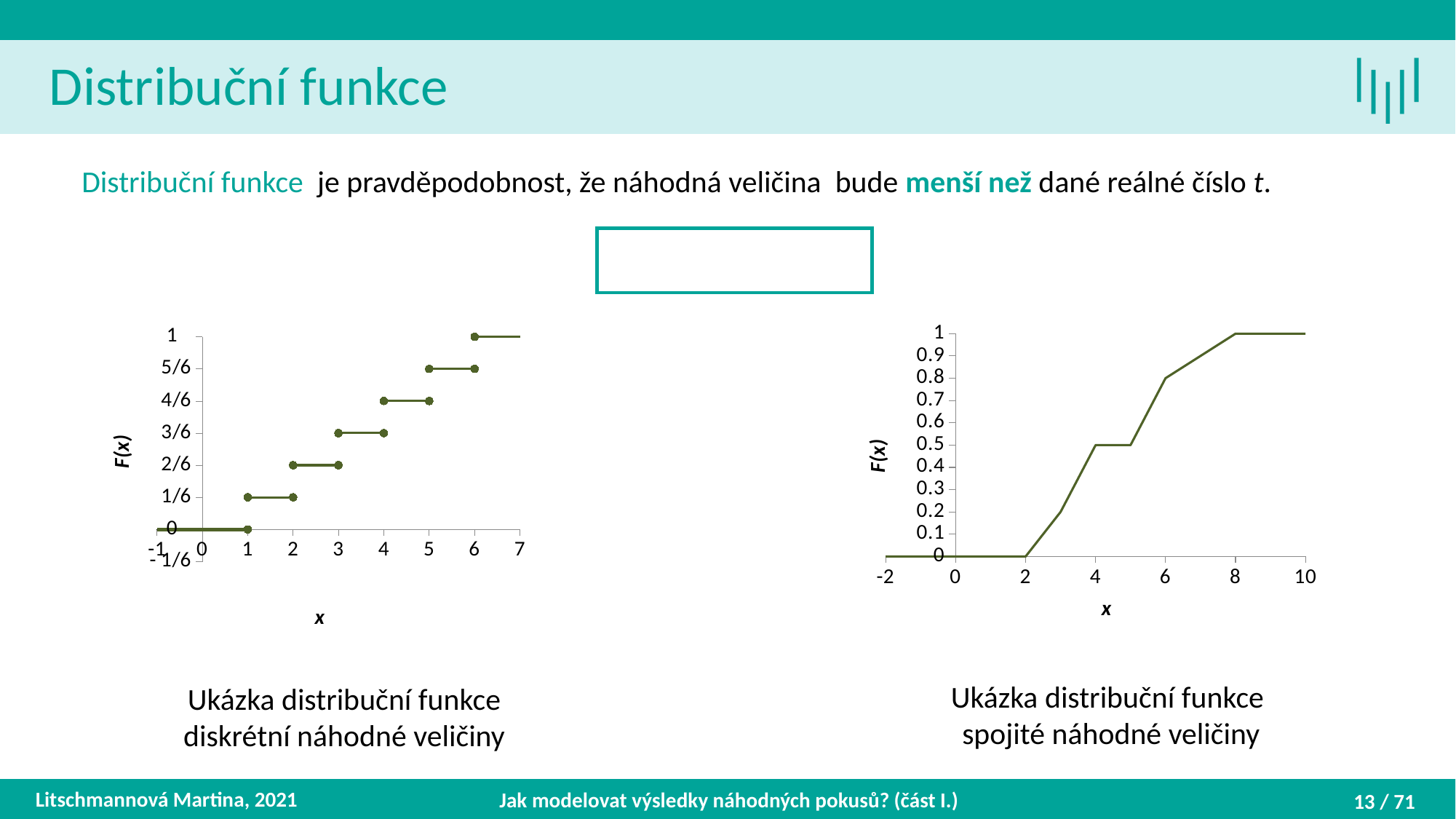
In the right chart (continuous distribution function), is the value of F(x) at x = 3 greater or less than 0.5? less In the left chart (discrete distribution function), do the values of F(x) rise or fall as x increases? rise In the left chart (discrete distribution function), what is the label of the vertical axis? F(x) What kind of chart is the right chart (continuous distribution function)? line chart In the right chart (continuous distribution function), what is the value of F(x) at x = 4? 0.5 In the right chart (continuous distribution function), what is the difference between F(x) at x = 6 and at x = 4? 0.3 In the right chart (continuous distribution function), what is the value of F(x) at x = 8? 1 In the right chart (continuous distribution function), what is the value of F(x) at x = 6? 0.8